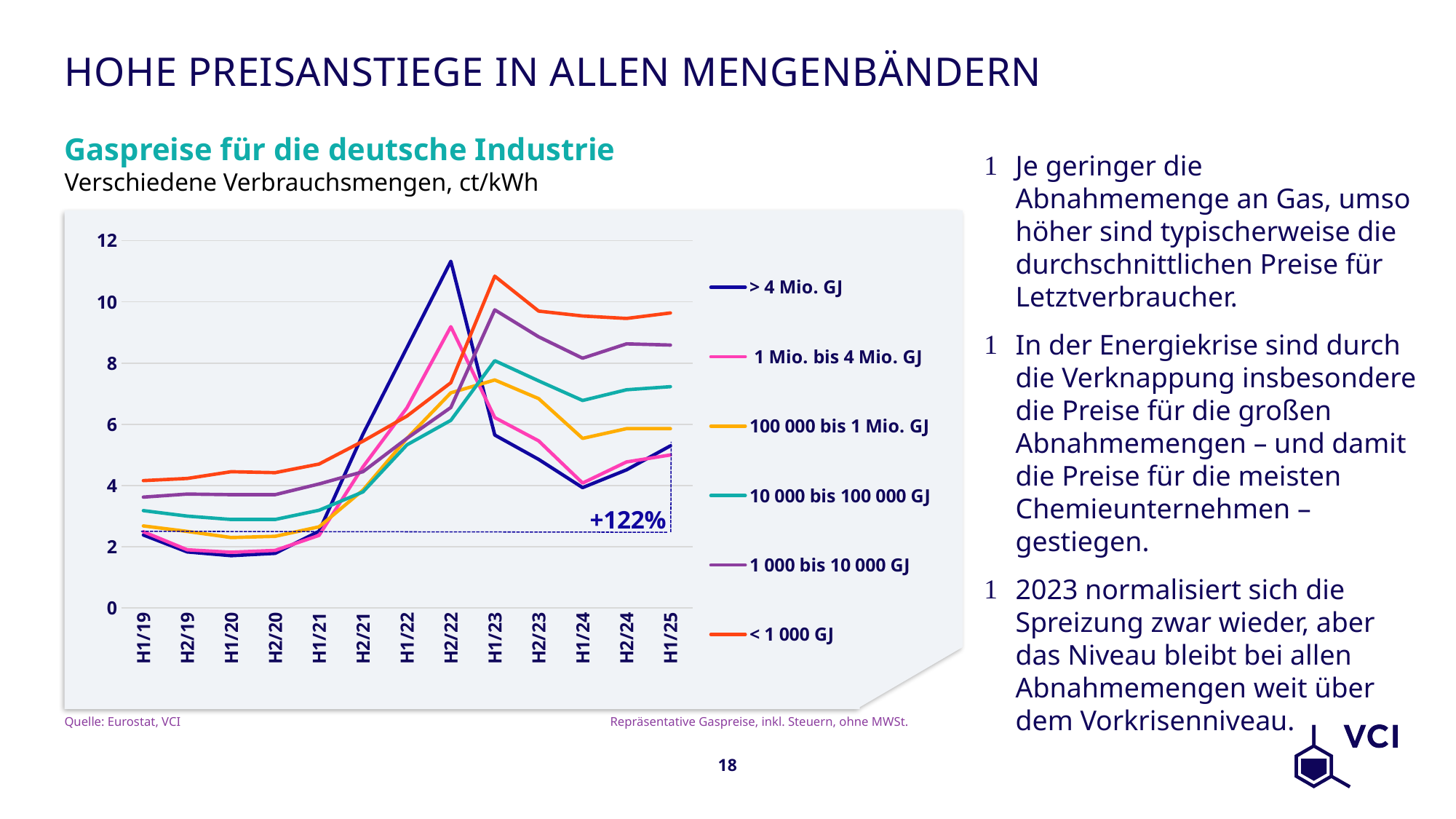
In which period does the '> 4 Mio. GJ' series reach its peak? H2/22 How many half-year periods are shown on the x axis? 13 In H2/22, which is larger: the value for '> 4 Mio. GJ' or for '< 1 000 GJ'? > 4 Mio. GJ Which series has the highest value in H1/25? < 1 000 GJ How many series does the legend list? 6 Is the value for '> 4 Mio. GJ' in H1/20 greater or less than 2? less What kind of chart is shown on the slide? line chart Is the value for '< 1 000 GJ' in H1/23 greater or less than 10? greater What percentage change is annotated on the chart for the '> 4 Mio. GJ' series? +122% Is the value for '> 4 Mio. GJ' in H2/22 greater or less than 10? greater In H1/25, which is larger: the value for '< 1 000 GJ' or for '> 4 Mio. GJ'? < 1 000 GJ